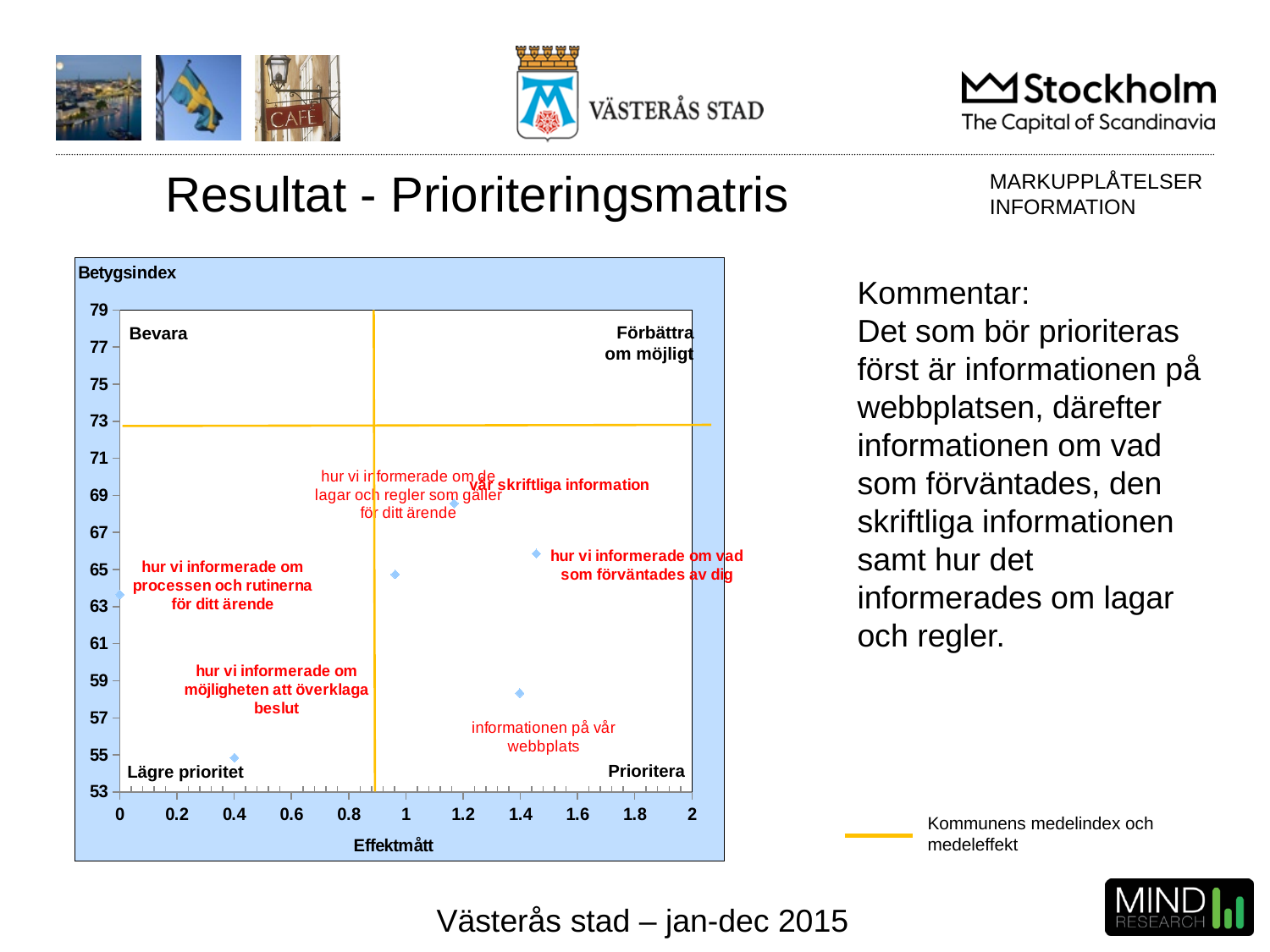
Is the Betygsindex value for 'informationen på vår webbplats' greater or less than 61? less How many data points are plotted in the chart? 6 Is the Betygsindex value for 'vår skriftliga information' greater or less than 67? greater Which point has the highest Betygsindex value? vår skriftliga information Which has a higher Betygsindex: 'hur vi informerade om vad som förväntades av dig' or 'informationen på vår webbplats'? hur vi informerade om vad som förväntades av dig What do the orange lines in the chart represent, according to the legend? Kommunens medelindex och medeleffekt Which point has the lowest Betygsindex value? hur vi informerade om möjligheten att överklaga beslut What is the label of the horizontal axis of the chart? Effektmått What kind of chart is shown on the slide? Scatter plot Which has a higher Effektmått: 'hur vi informerade om processen och rutinerna för ditt ärende' or 'hur vi informerade om de lagar och regler som gäller för ditt ärende'? hur vi informerade om de lagar och regler som gäller för ditt ärende Is the Effektmått value for 'hur vi informerade om vad som förväntades av dig' greater or less than 1.2? greater